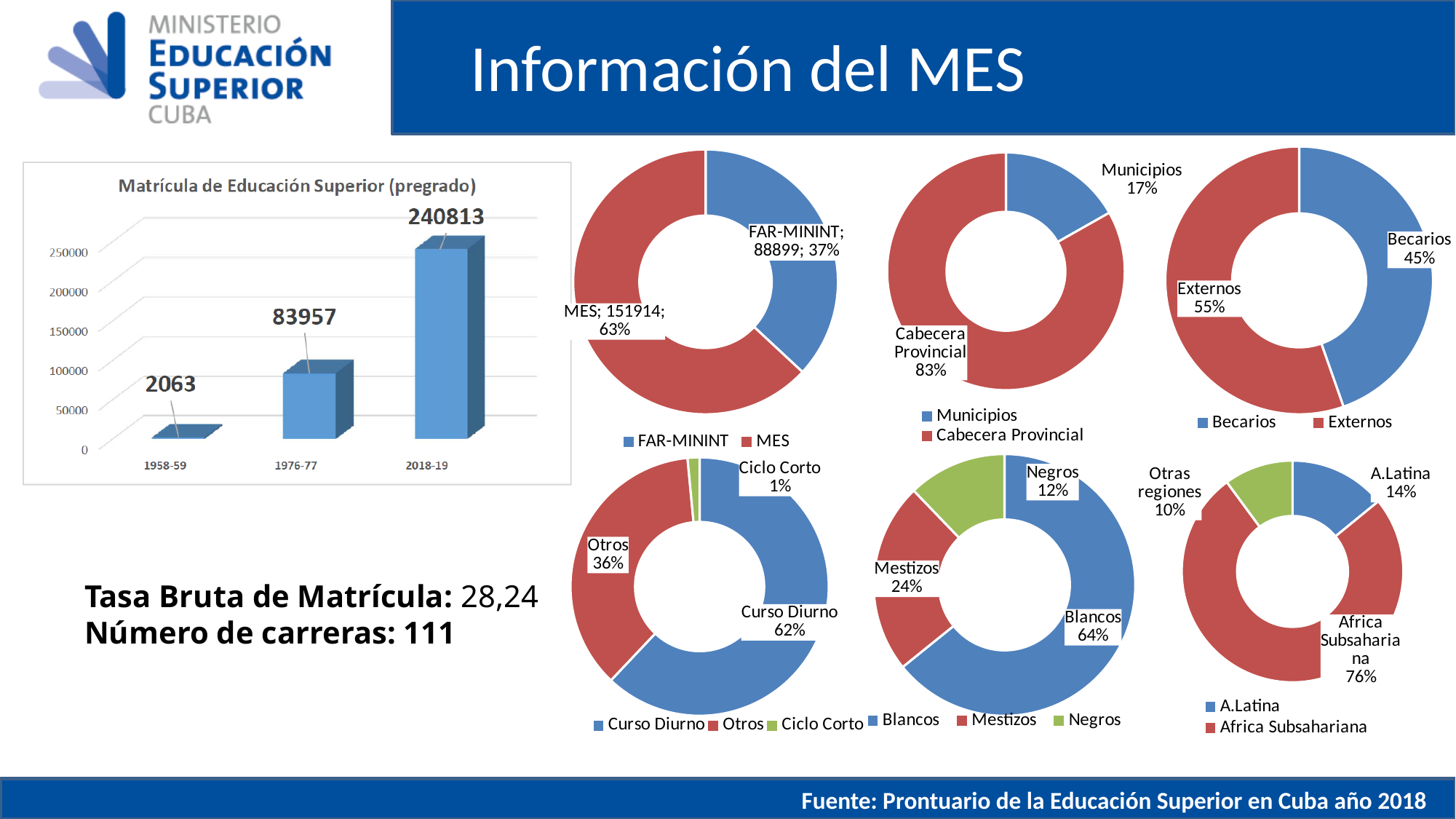
In the bar chart 'Matrícula de Educación Superior (pregrado)', what is the difference between the 2018-19 and 1976-77 values? 156856 In the bar chart 'Matrícula de Educación Superior (pregrado)', how many periods are shown on the x axis? 3 In the bar chart 'Matrícula de Educación Superior (pregrado)', do the values rise or fall from 1958-59 to 2018-19? rise In the doughnut chart with the Becarios and Externos legend, which segment is larger, Becarios or Externos? Externos In the doughnut chart with the FAR-MININT and MES legend, what value is shown for MES? 151914; 63% In the bar chart 'Matrícula de Educación Superior (pregrado)', which period has the lowest value? 1958-59 In the doughnut chart with the Curso Diurno, Otros and Ciclo Corto legend, what share does Ciclo Corto have? 1% What kind of chart is 'Matrícula de Educación Superior (pregrado)'? bar chart In the bar chart 'Matrícula de Educación Superior (pregrado)', what is the value for 2018-19? 240813 In the doughnut chart with the Blancos, Mestizos and Negros legend, what is the difference between the Blancos and Mestizos shares? 40% In the doughnut chart with the Municipios and Cabecera Provincial legend, what share does Cabecera Provincial have? 83% How many entries does the legend of the doughnut chart with A.Latina and Africa Subsahariana list? 2